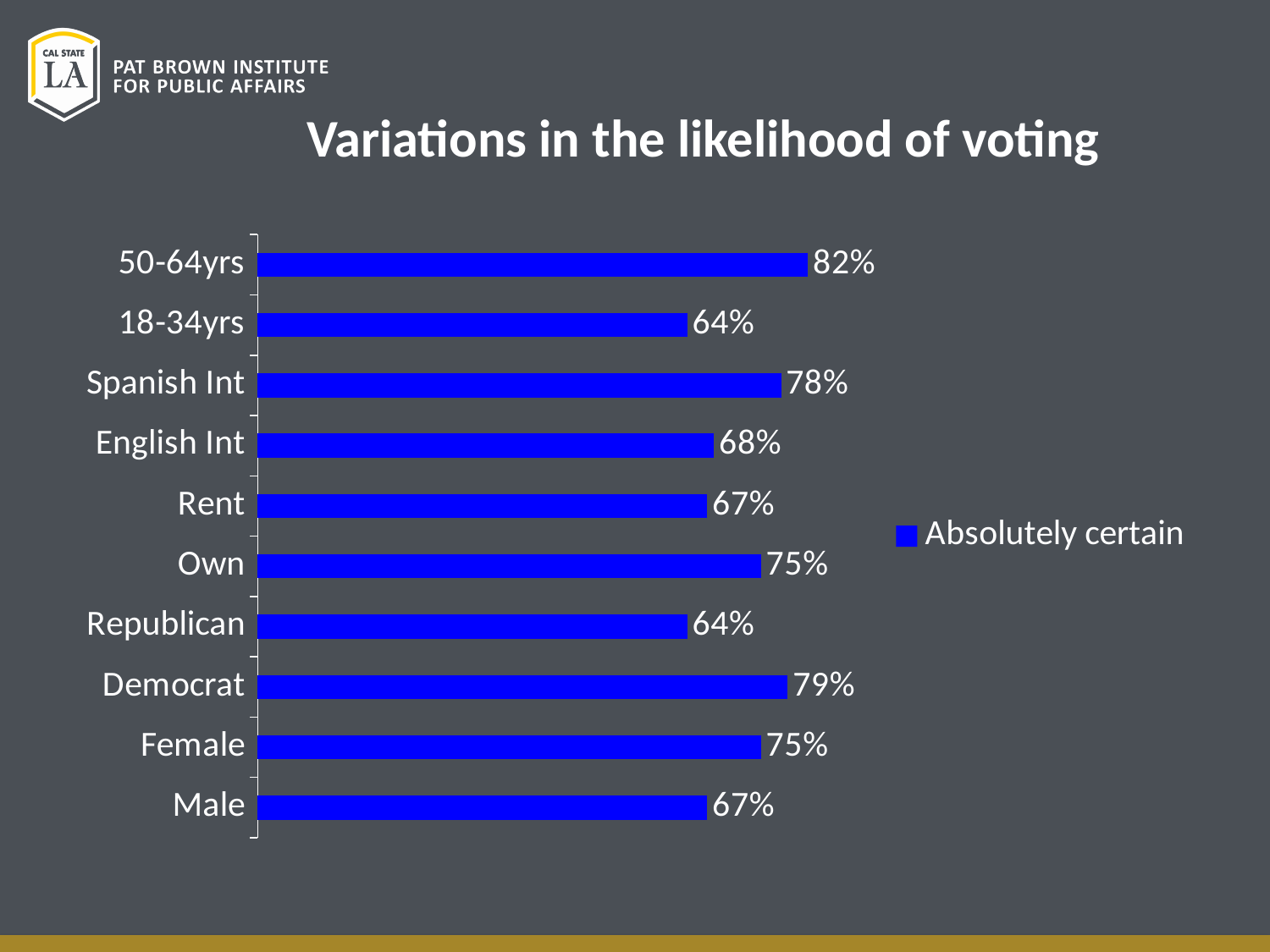
What is the value for 50-64yrs? 82% What is the difference between the values for 50-64yrs and 18-34yrs? 18% What kind of chart is shown on the slide? Bar chart How many categories are shown on the chart? 10 Which is larger, the value for Spanish Int or the value for English Int? Spanish Int Which category has the highest value? 50-64yrs What is the difference between the values for Democrat and Republican? 15% What is the value for Democrat? 79% What is the value for Rent? 67% What is the title of the chart? Variations in the likelihood of voting Which is larger, the value for Female or the value for Male? Female How many series does the legend list? 1